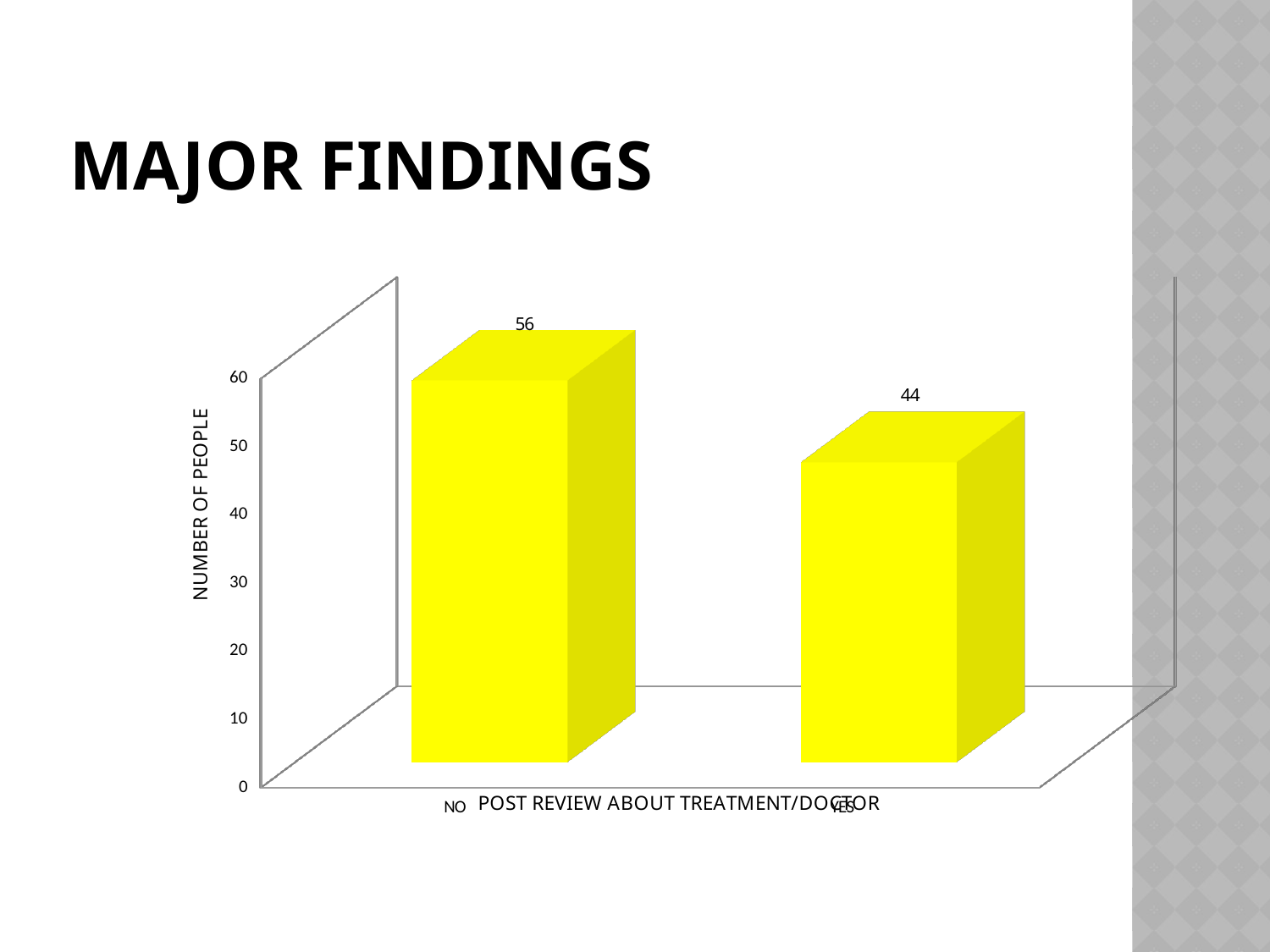
What is the value for YES? 44 What is the difference between the values for NO and YES? 12 Is the value for NO greater or less than 50? greater What is the label of the horizontal axis? POST REVIEW ABOUT TREATMENT/DOCTOR What is the value for NO? 56 Which category has the highest number of people? NO How many categories are shown on the x axis? 2 Which category has the lowest number of people? YES Is the value for YES greater or less than 50? less Which is larger, the value for NO or the value for YES? NO What is the label of the vertical axis? NUMBER OF PEOPLE What kind of chart is shown on the slide? bar chart